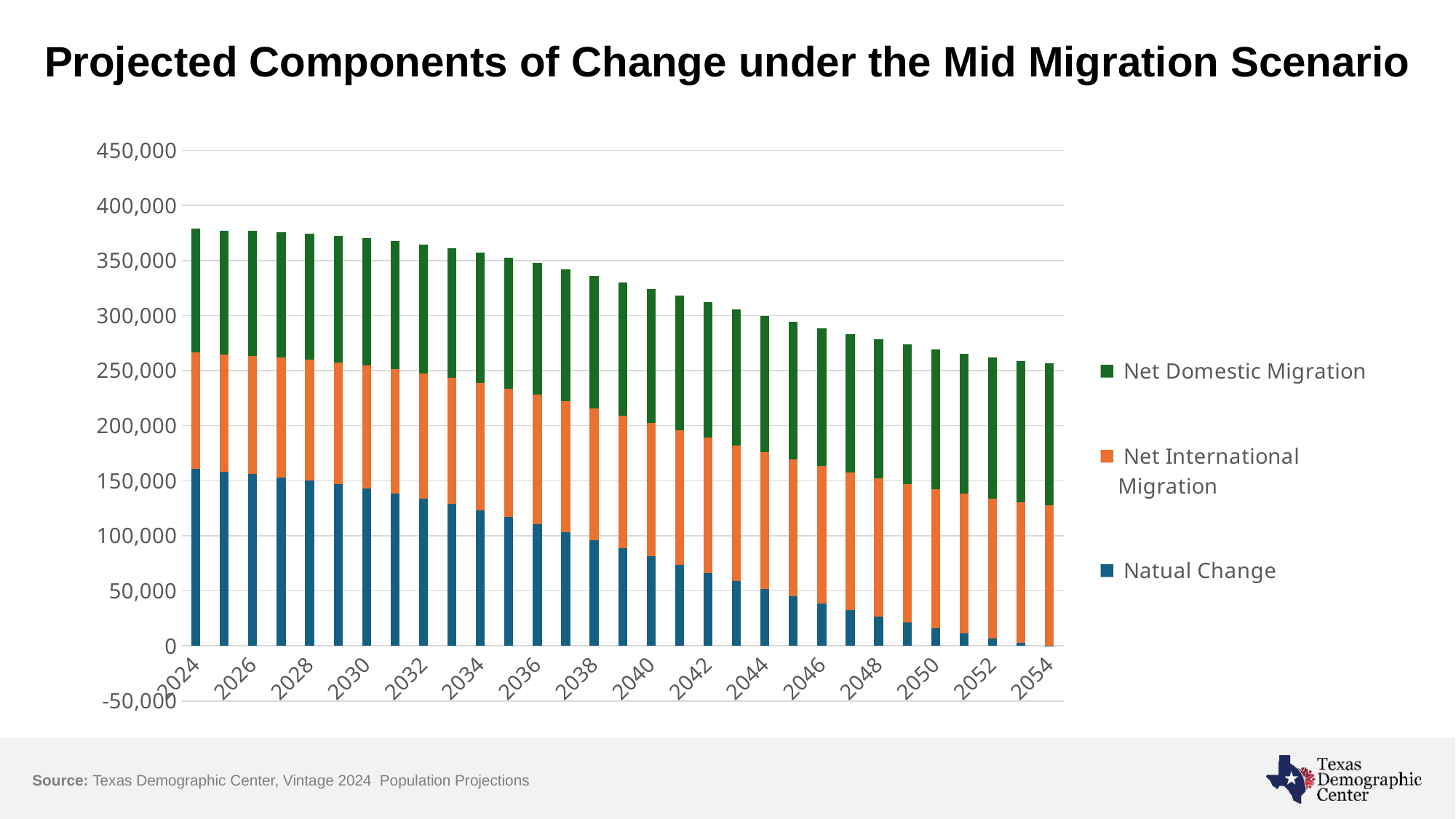
Which series is shown in green? Net Domestic Migration What kind of chart is shown on the slide? Stacked bar chart Which year has the shortest total bar? 2054 How many series does the legend list? 3 Is the total bar height for 2024 greater or less than 400,000? less Is the Natual Change value for 2040 greater or less than 100,000? less How many years (bars) are plotted on the x axis? 31 Is the Natual Change value for 2024 greater or less than 150,000? greater Which year has the larger Natual Change value, 2024 or 2050? 2024 What is the title of the chart? Projected Components of Change under the Mid Migration Scenario Do the total bar heights rise or fall from 2024 to 2054? Fall Which year has the tallest total bar? 2024